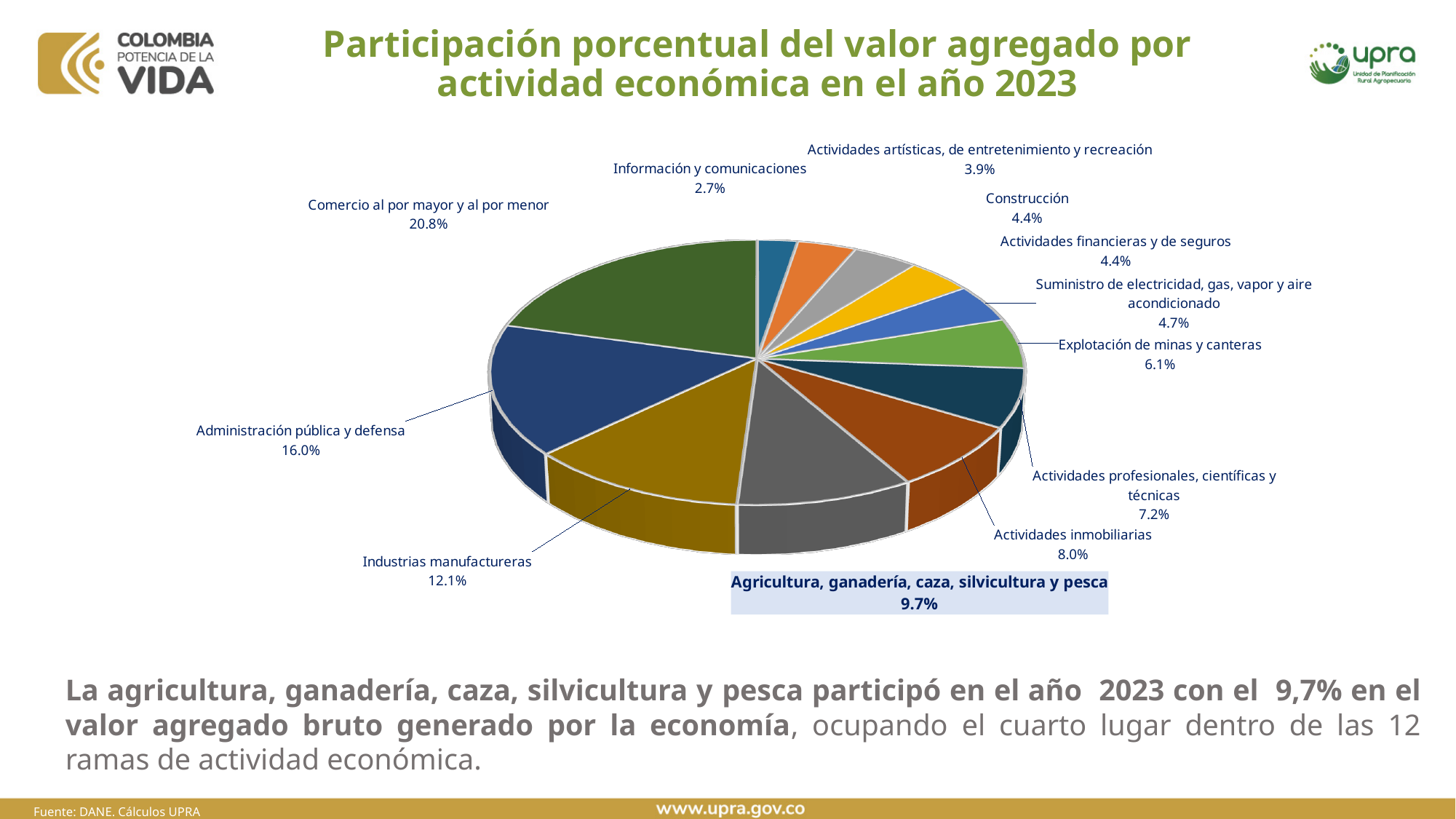
Which activity has the largest share of the pie? Comercio al por mayor y al por menor What kind of chart is shown on the slide? Pie chart What is the share for Explotación de minas y canteras? 6.1% Which activity has the smallest share of the pie? Información y comunicaciones What is the share for Agricultura, ganadería, caza, silvicultura y pesca? 9.7% What is the difference between the shares of Administración pública y defensa and Industrias manufactureras? 3.9% What is the share for Industrias manufactureras? 12.1% What is the combined share of Construcción and Actividades financieras y de seguros? 8.8% What is the share for Comercio al por mayor y al por menor? 20.8% What is the title of the chart? Participación porcentual del valor agregado por actividad económica en el año 2023 How many categories (slices) does the pie chart show? 12 Which is larger, the share for Actividades inmobiliarias or the share for Actividades profesionales, científicas y técnicas? Actividades inmobiliarias